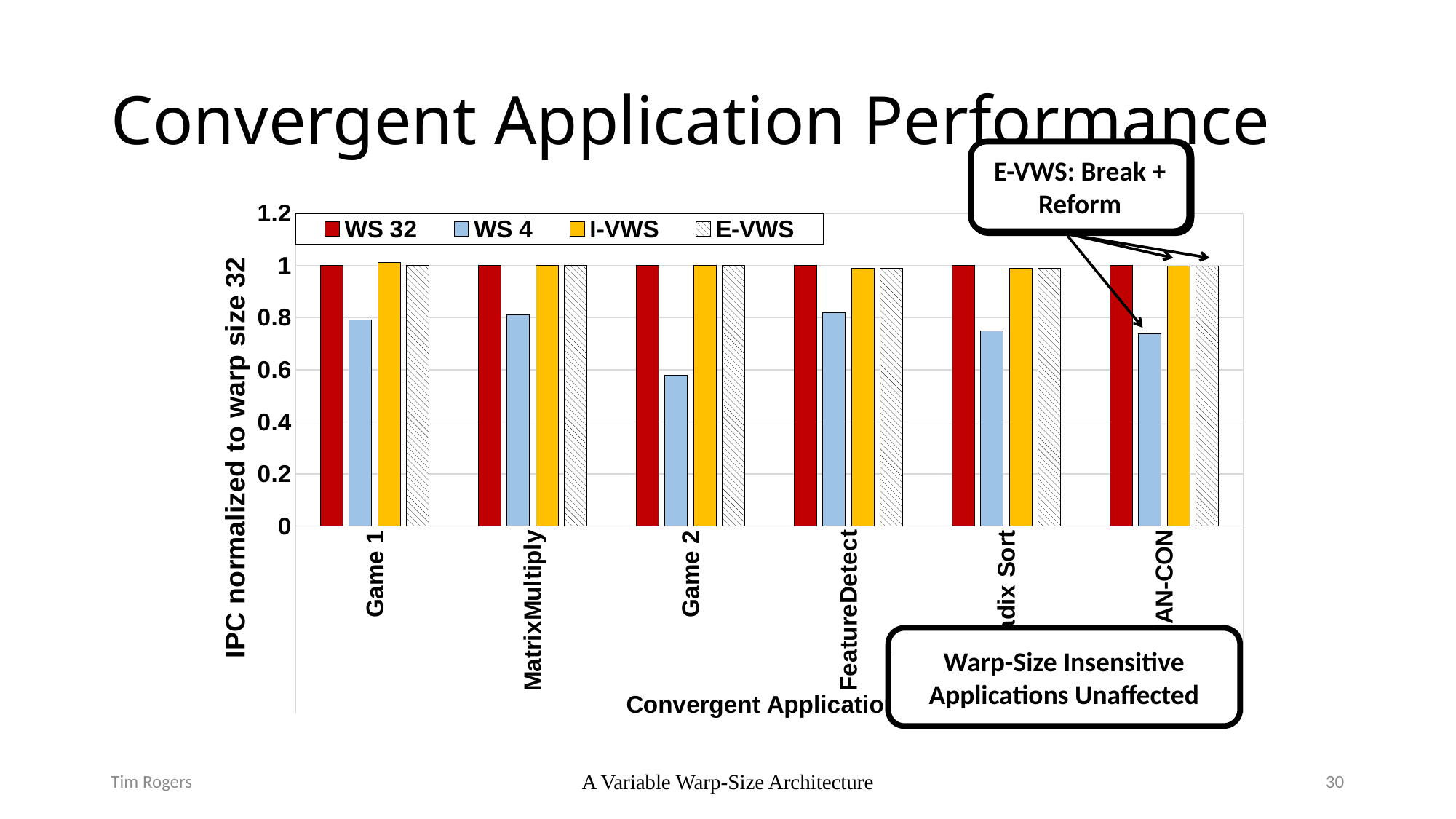
Which is larger, the WS 4 value for MatrixMultiply or the WS 4 value for Game 2? MatrixMultiply Is the WS 4 value for Game 2 greater or less than 0.8? less Is the WS 4 value for FeatureDetect greater or less than 0.6? greater How many series does the legend list? 4 Is the WS 4 value for MatrixMultiply greater or less than 0.6? greater Which is larger for Game 1, the WS 32 value or the WS 4 value? WS 32 What is the WS 32 value for Game 1? 1 How many application groups (categories) are plotted on the x axis? 6 Which application has the lowest WS 4 value? Game 2 What kind of chart is shown on the slide? bar chart What is the title of the y axis? IPC normalized to warp size 32 What is the WS 32 value for MatrixMultiply? 1